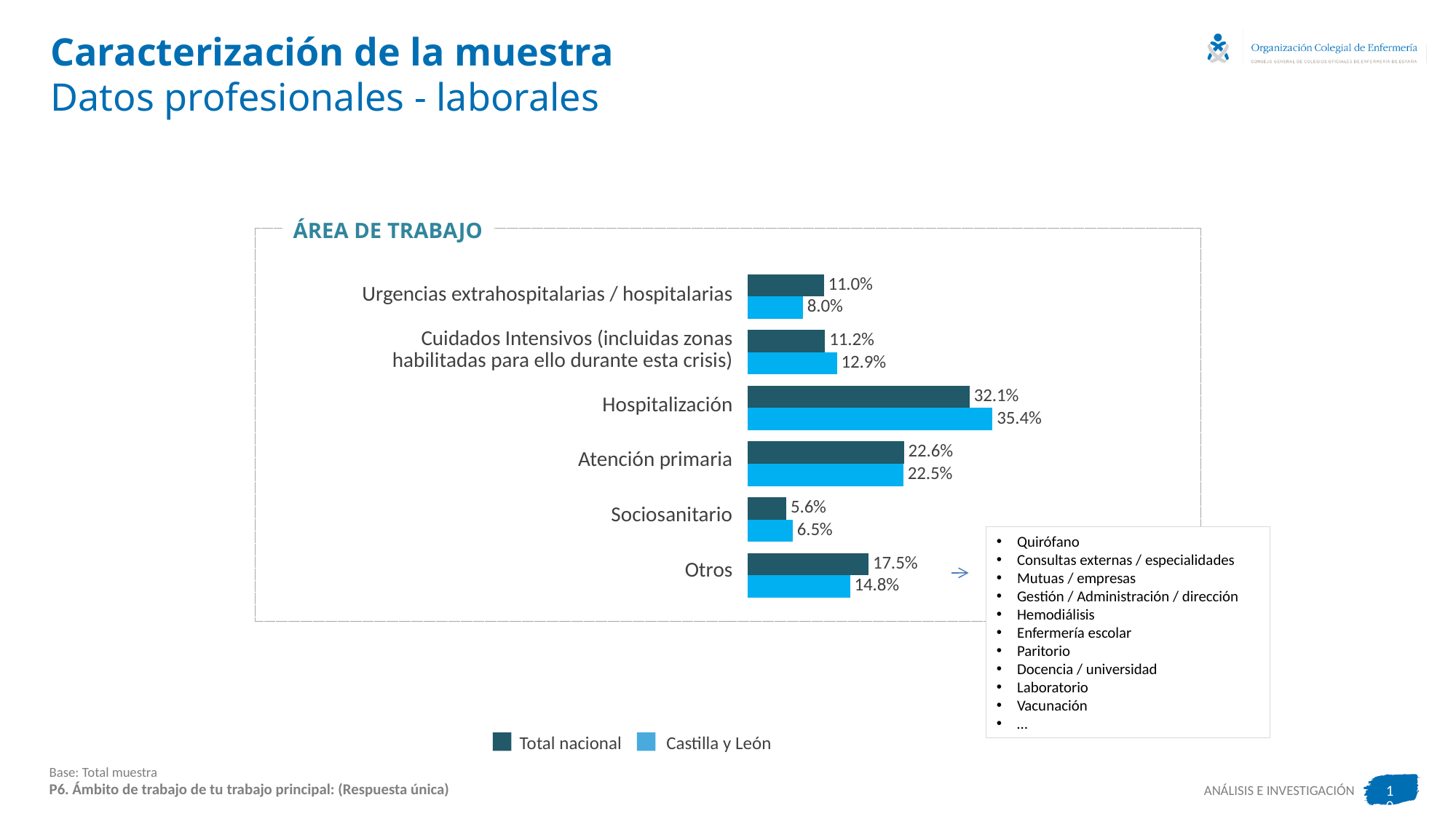
What is the difference between the Castilla y León and Total nacional values for Hospitalización? 3.3% What is the Castilla y León value for Cuidados Intensivos (incluidas zonas habilitadas para ello durante esta crisis)? 12.9% How many categories are shown in the chart? 6 What is the title of the chart? ÁREA DE TRABAJO What is the difference between the Total nacional and Castilla y León values for Urgencias extrahospitalarias / hospitalarias? 3.0% What is the Total nacional value for Hospitalización? 32.1% What is the Castilla y León value for Otros? 14.8% How many series does the legend list? 2 Which category has the lowest Total nacional value? Sociosanitario Which category has the highest Castilla y León value? Hospitalización What kind of chart is shown on the slide? Bar chart Which is larger for Sociosanitario, the Total nacional value or the Castilla y León value? Castilla y León